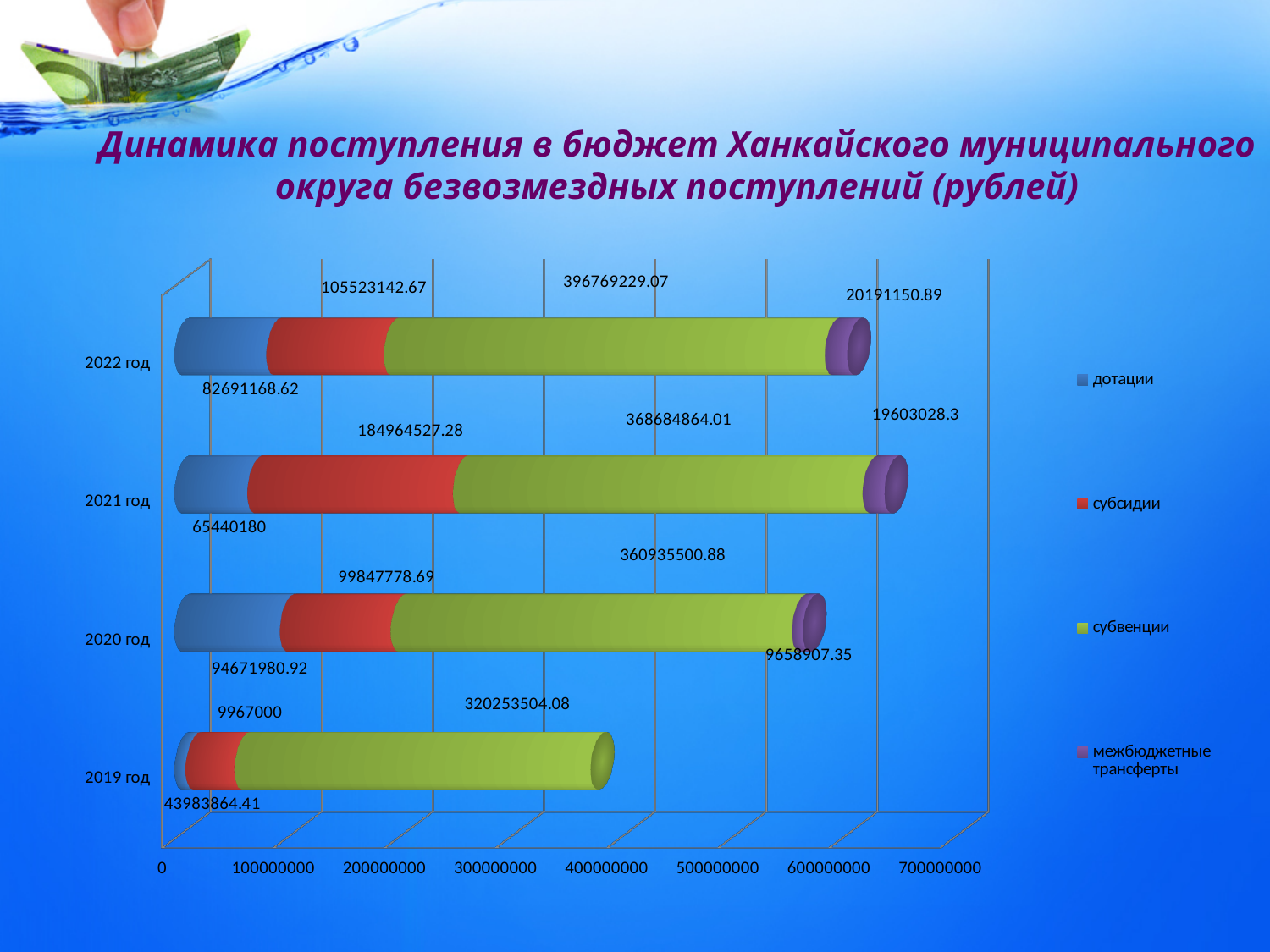
In which year is the value of субсидии the highest? 2021 год What is the value of субвенции for 2022 год? 396769229.07 What is the value of дотации for 2019 год? 9967000 What is the value of субсидии for 2021 год? 184964527.28 Do the values of субвенции rise or fall from 2019 год to 2022 год? Rise In which year is the value of дотации the lowest? 2019 год Which is larger: дотации in 2020 год or дотации in 2022 год? 2020 год How many years (categories) are shown on the chart? 4 What is the value of межбюджетные трансферты for 2020 год? 9658907.35 What kind of chart is shown on the slide? Stacked bar chart How many series does the legend list? 4 What is the difference between субвенции in 2022 год and in 2021 год? 28084365.06